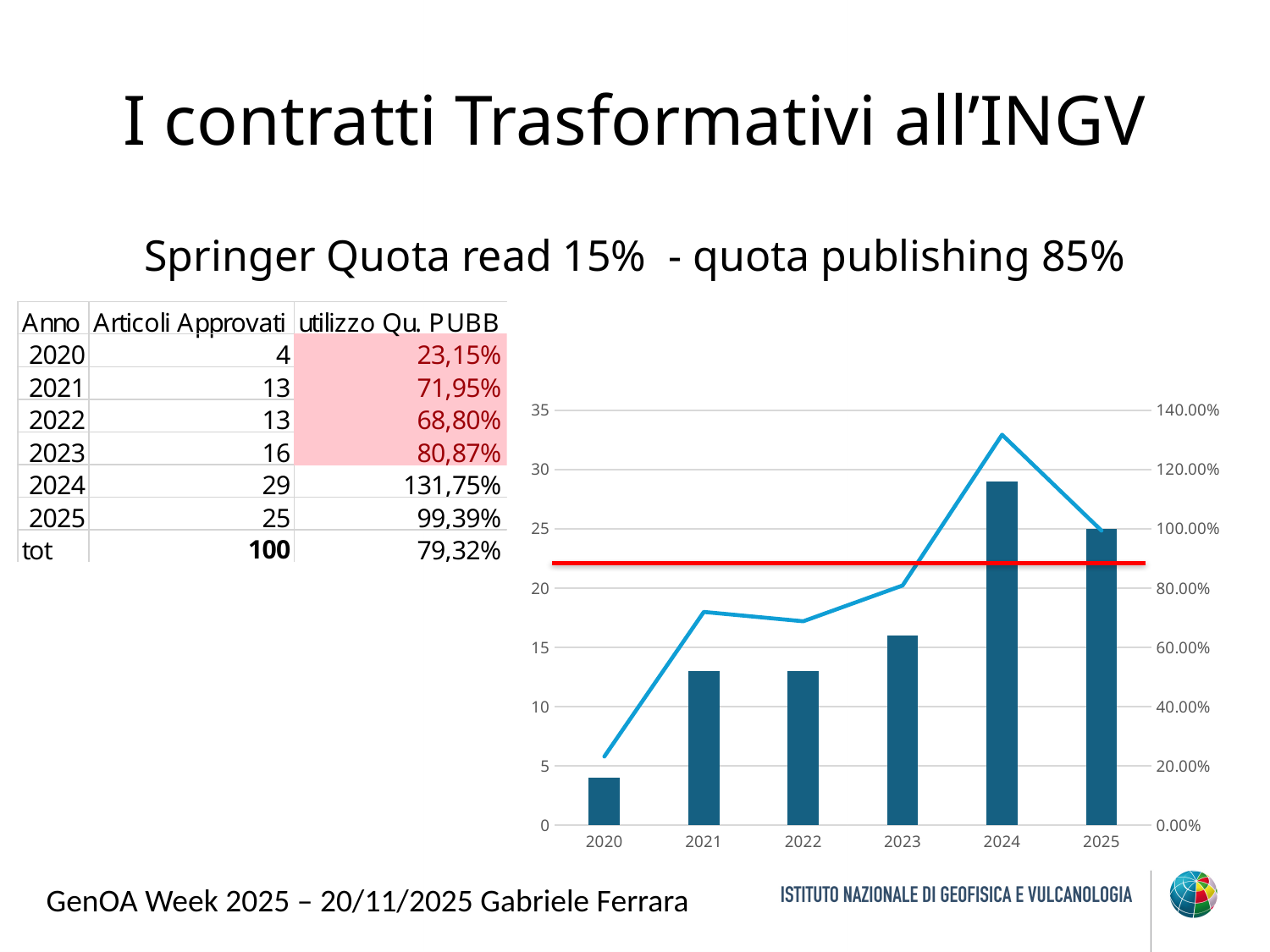
Using the Articoli Approvati values in the table, what is the difference between 2024 and 2025? 4 Does the blue line rise or fall from 2023 to 2024? rise Is the bar for 2021 greater or less than 10 on the left axis? greater According to the table, what is the utilizzo Qu. PUBB value for 2024? 131,75% What is the value of the bar for 2025 on the left axis? 25 Which year has the tallest bar in the chart? 2024 How many years are shown on the x axis of the chart? 6 Is the bar for 2020 greater or less than 5 on the left axis? less Which bar is taller, 2024 or 2025? 2024 Which year has the shortest bar in the chart? 2020 Is the blue line value for 2024 greater or less than 120.00% on the right axis? greater What kind of chart is shown on the slide? bar chart with a line